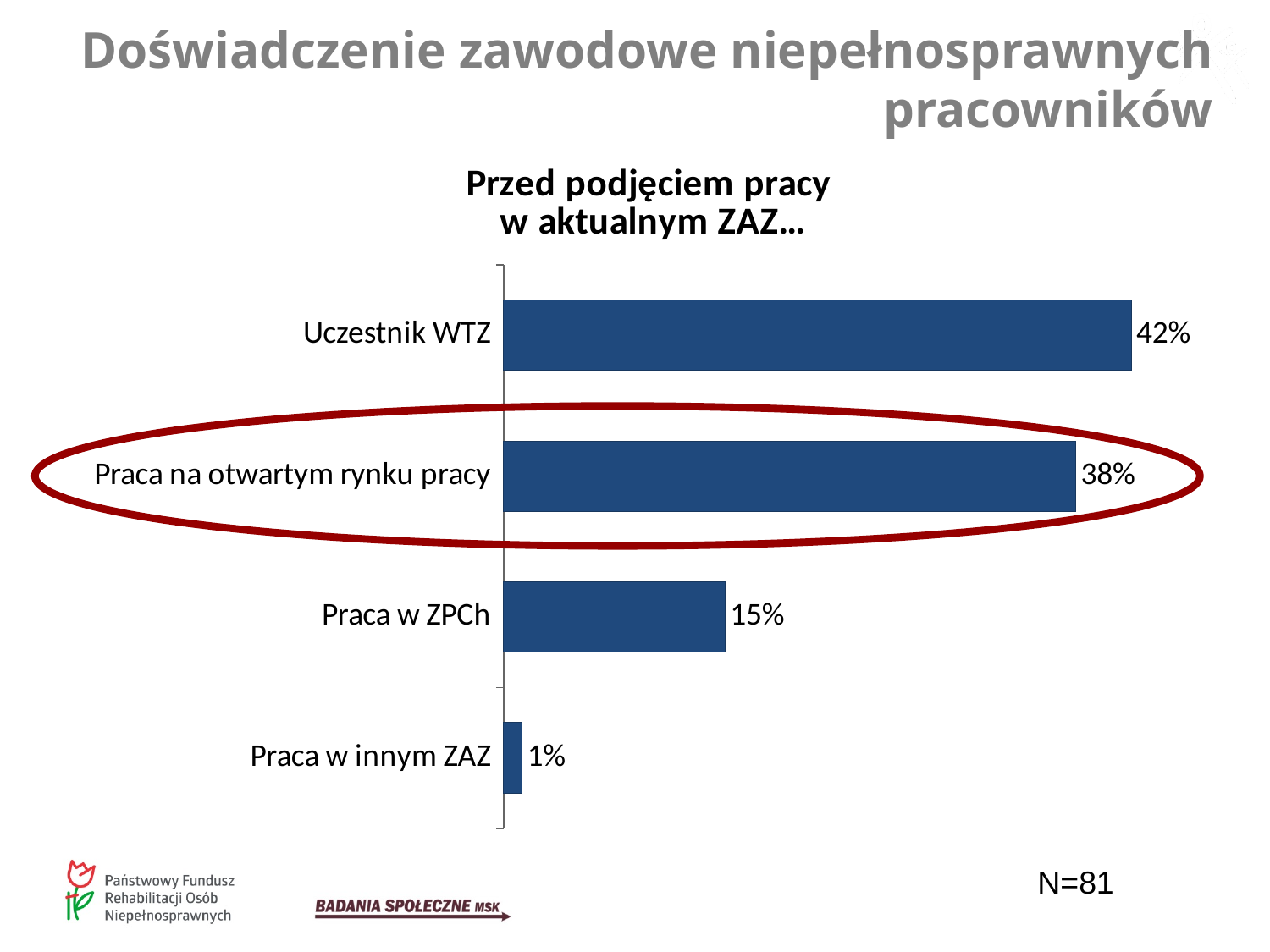
What kind of chart is shown on the slide? Bar chart How many categories are shown in the chart? 4 What is the difference between the values for Uczestnik WTZ and Praca na otwartym rynku pracy? 4% Which category has the highest value? Uczestnik WTZ What is the value for Praca w innym ZAZ? 1% What is the title of the chart? Przed podjęciem pracy w aktualnym ZAZ… What is the value for Praca w ZPCh? 15% What is the value for Uczestnik WTZ? 42% What is the value for Praca na otwartym rynku pracy? 38% Which is larger, the value for Praca w ZPCh or the value for Praca w innym ZAZ? Praca w ZPCh Which category has the lowest value? Praca w innym ZAZ What is the difference between the values for Praca na otwartym rynku pracy and Praca w ZPCh? 23%